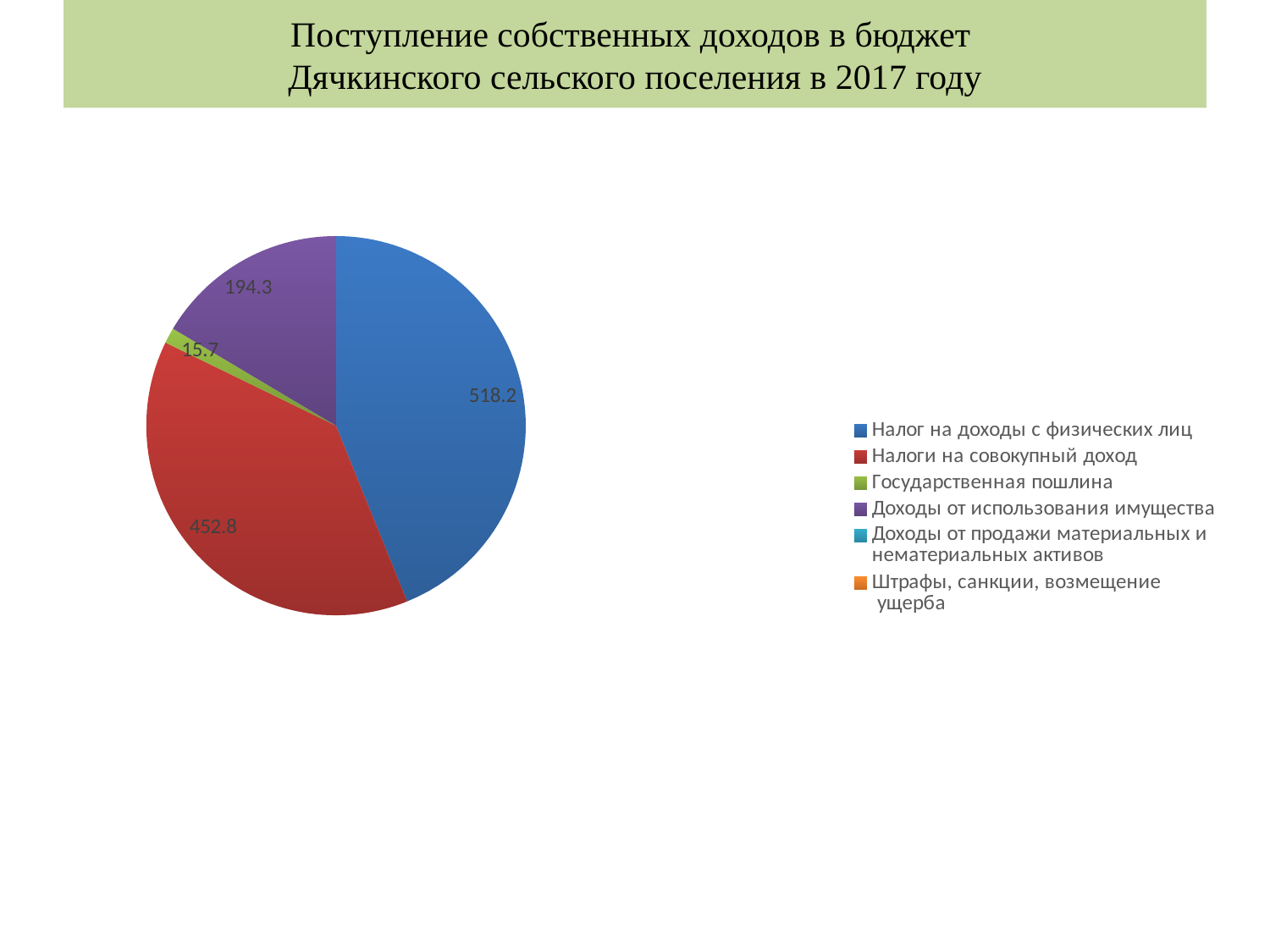
What is the value for Налог на доходы с физических лиц? 518.2 Which labelled category has the smallest slice of the pie? Государственная пошлина What is the difference between the values for Налог на доходы с физических лиц and Налоги на совокупный доход? 65.4 Which is larger: Доходы от использования имущества or Государственная пошлина? Доходы от использования имущества What colour is the slice for Налоги на совокупный доход? Red What is the difference between the values for Налоги на совокупный доход and Доходы от использования имущества? 258.5 Which category has the largest slice of the pie? Налог на доходы с физических лиц What is the value for Налоги на совокупный доход? 452.8 How many categories does the legend list? 6 What type of chart is shown on the slide? Pie chart What is the value for Доходы от использования имущества? 194.3 What is the value for Государственная пошлина? 15.7